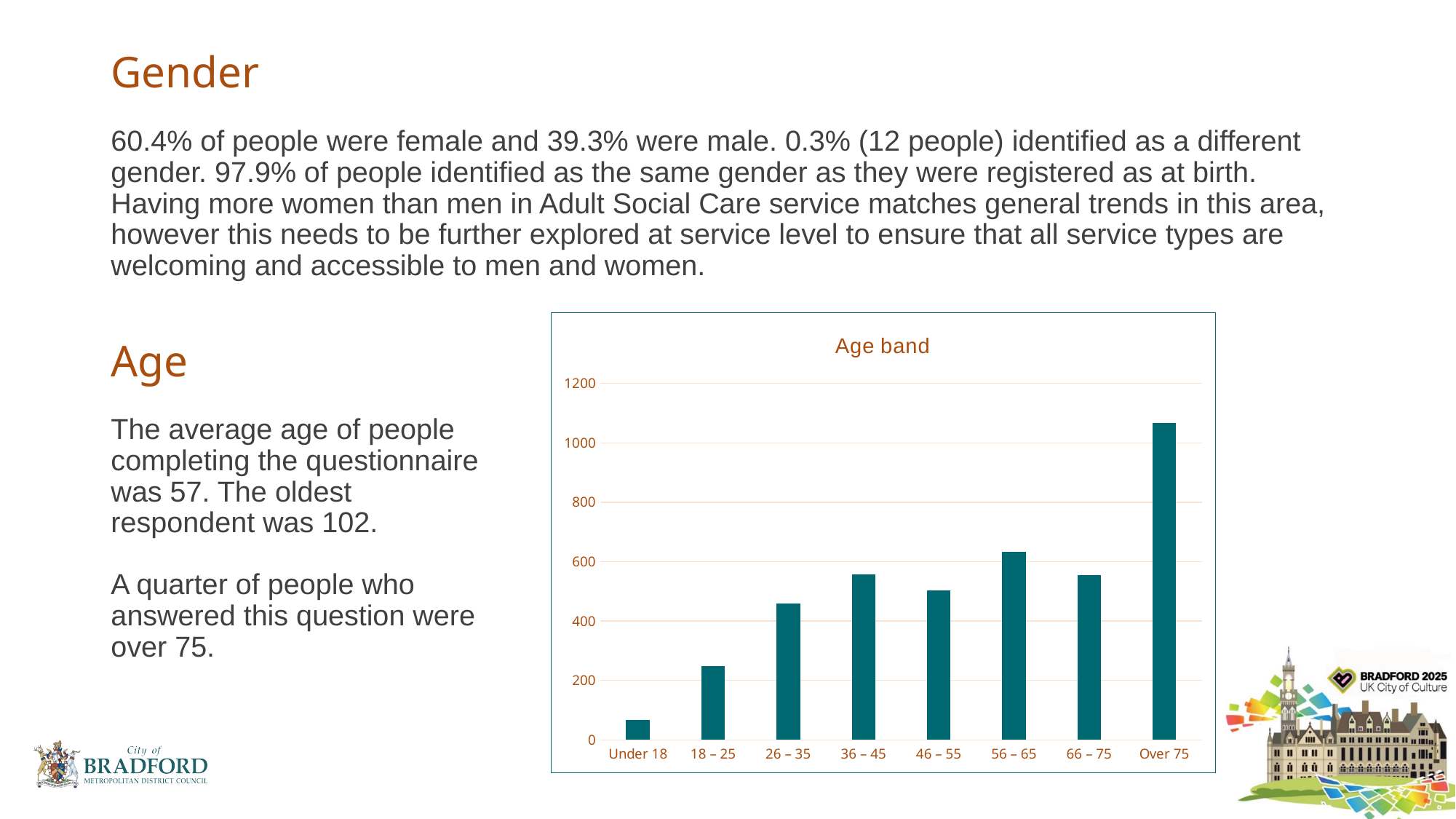
Which age band has the lowest value in the chart? Under 18 Is the value for Over 75 greater or less than 1000? greater What is the title of the chart? Age band Is the value for Under 18 greater or less than 200? less How many age bands are shown on the x axis of the chart? 8 Is the value for 46 – 55 greater or less than 600? less What type of chart is shown on the slide? bar chart Which has the larger value, 56 – 65 or 46 – 55? 56 – 65 Which age band has the highest value in the chart? Over 75 Which has the larger value, 18 – 25 or 26 – 35? 26 – 35